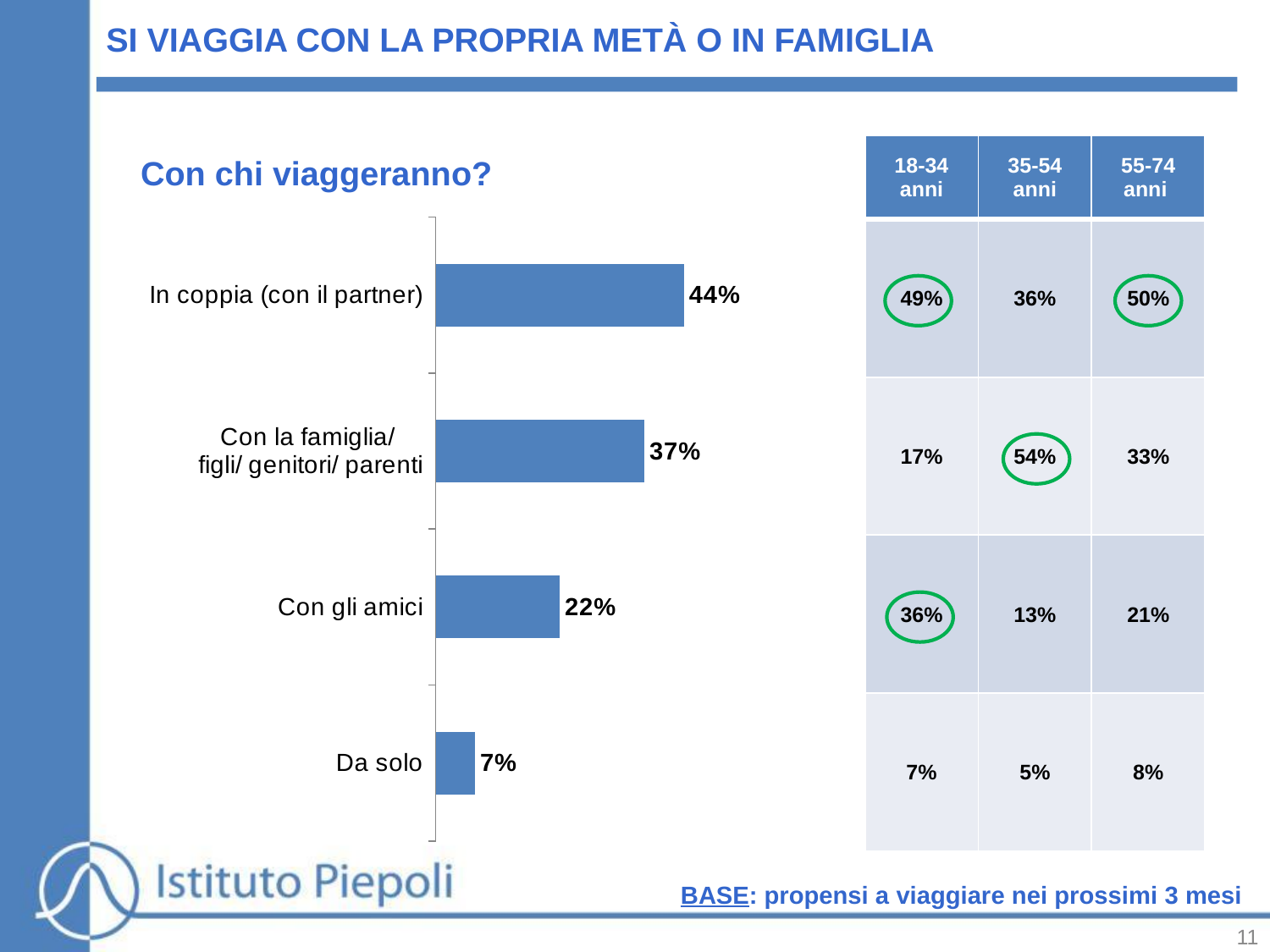
What is the difference between the values for "In coppia (con il partner)" and "Con la famiglia/ figli/ genitori/ parenti"? 7% What is the value for "Da solo" in the bar chart? 7% What is the title of the chart? Con chi viaggeranno? Which category has the lowest value in the bar chart? Da solo How many categories are shown in the bar chart? 4 Which category has the highest value in the bar chart? In coppia (con il partner) What is the value for "In coppia (con il partner)" in the bar chart? 44% What is the value for "Con gli amici" in the bar chart? 22% What is the difference between the values for "Con gli amici" and "Da solo"? 15% What colour are the bars in the chart? Blue Which is larger: the value for "Con la famiglia/ figli/ genitori/ parenti" or the value for "Con gli amici"? Con la famiglia/ figli/ genitori/ parenti What kind of chart is shown on the slide? Bar chart